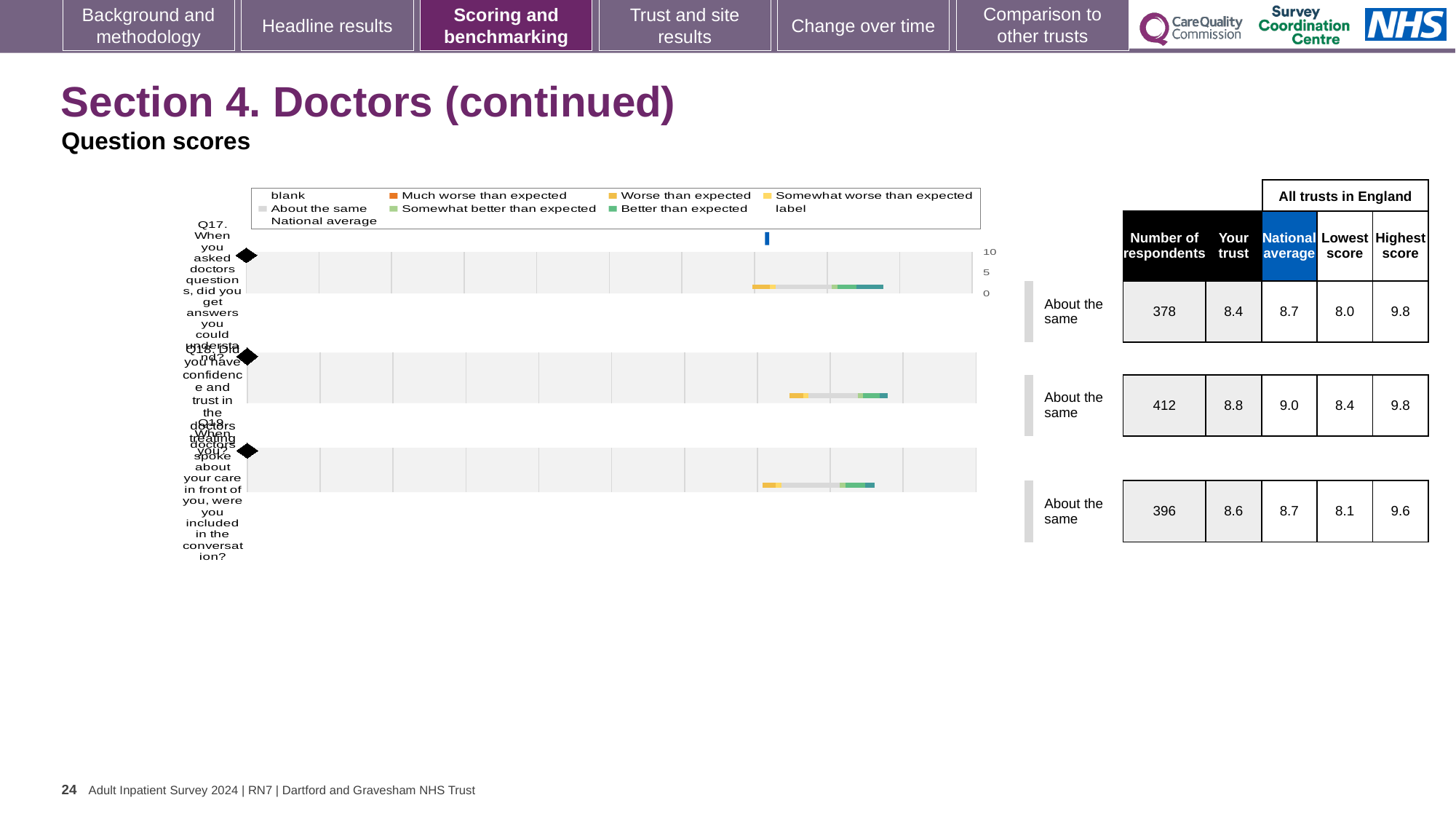
What is the national average score for Q18 (confidence and trust in the doctors treating you)? 9.0 What is the 'Your trust' score for Q17 (when you asked doctors questions, did you get answers you could understand)? 8.4 What benchmark category is shown for Q17? About the same What kind of chart is used to show the question scores on this slide? bar chart Which question has the highest 'Your trust' score? Q18 Which question has the lowest 'Your trust' score? Q17 Which has the larger 'Your trust' score, Q17 or Q19? Q19 What is the lowest score across all trusts in England for Q18? 8.4 How many questions (Q17, Q18, Q19) are plotted in the chart? 3 What is the difference between the national average and the 'Your trust' score for Q18? 0.2 What is the highest score across all trusts in England for Q19? 9.6 How many respondents answered Q19 (were you included in the conversation when doctors spoke about your care)? 396